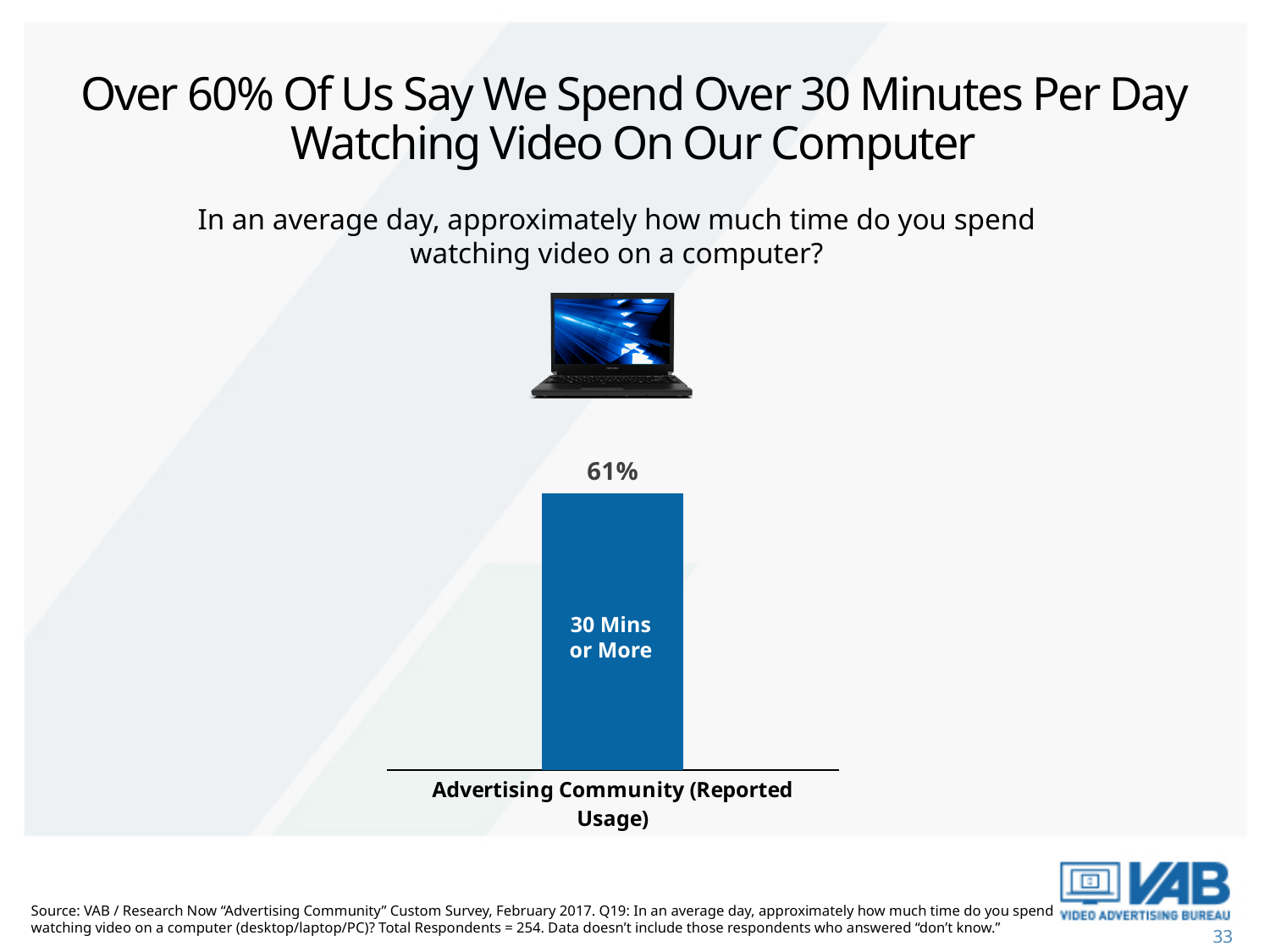
Is the value shown for the Advertising Community bar greater or less than 50%? greater What kind of chart is shown on the slide? bar chart What is the category label shown on the x axis of the chart? Advertising Community (Reported Usage) How many bars are plotted in the chart? 1 What text label is printed inside the bar? 30 Mins or More What percentage of the Advertising Community reports watching video on a computer for 30 minutes or more per day? 61% What is the data label printed above the bar in the chart? 61%